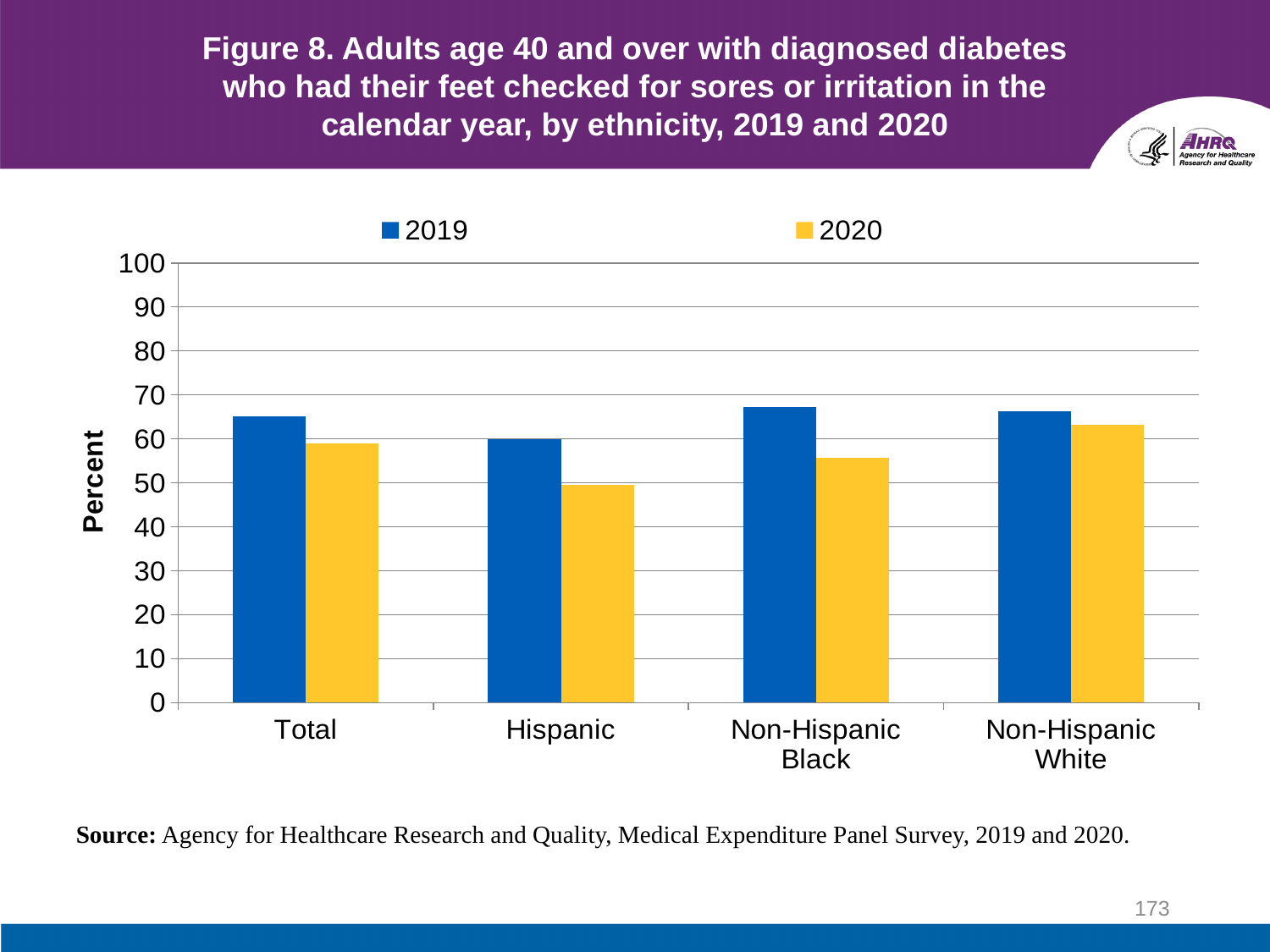
Is the value for Non-Hispanic Black in 2019 greater or less than 70? less For Non-Hispanic White adults, which year has the larger value, 2019 or 2020? 2019 For Hispanic adults, which year has the larger value, 2019 or 2020? 2019 What is the label on the y axis? Percent How many ethnicity categories are shown on the x axis? 4 Which category has the highest value for 2020? Non-Hispanic White Which category has the lowest value for 2019? Hispanic Which category has the lowest value for 2020? Hispanic Is the value for Non-Hispanic Black in 2020 greater or less than 50? greater Is the value for Total in 2019 greater or less than 60? greater What kind of chart is shown on the slide? bar chart How many series does the legend list? 2